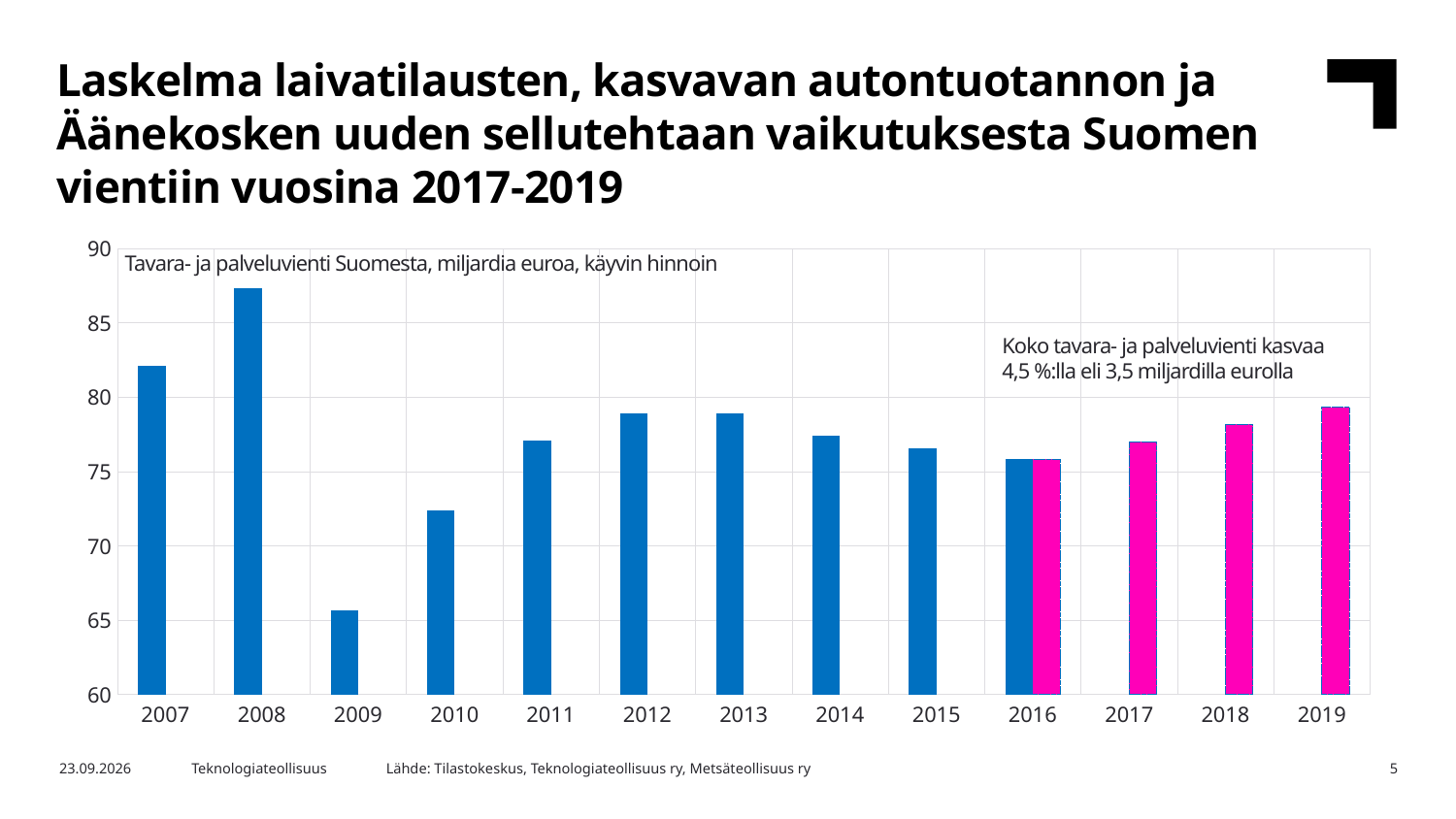
Is the value for 2019 greater or less than 80? less According to the annotation on the chart, by how many billion euros does total goods and services export grow? 3,5 miljardilla eurolla Do the values rise or fall from 2016 to 2019? rise Which year has the larger value, 2007 or 2010? 2007 Is the value for 2009 greater or less than 70? less What kind of chart is shown on the slide? bar chart Which year has the lowest export value in the chart? 2009 Is the value for 2008 greater or less than 85? greater Which year has the highest export value in the chart? 2008 How many years are shown on the x axis of the chart? 13 Do the values rise or fall from 2008 to 2009? fall